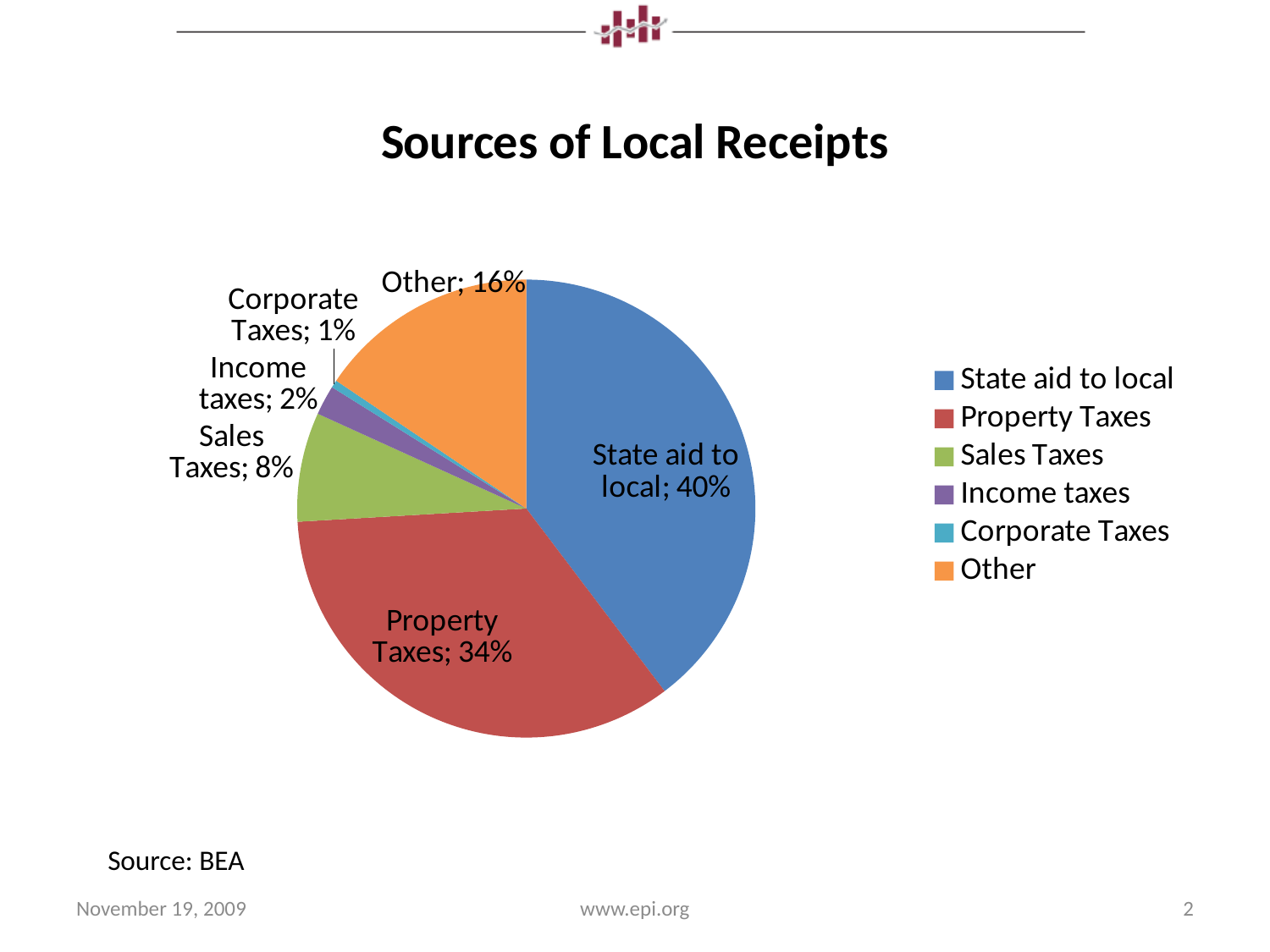
Which source accounts for the largest share of local receipts? State aid to local What share of local receipts comes from Sales Taxes? 8% How many percentage points larger is the State aid to local share than the Property Taxes share? 6 Which is larger, the share for Other or the share for Sales Taxes? Other Which source accounts for the smallest share of local receipts? Corporate Taxes What share of local receipts comes from State aid to local? 40% What share of local receipts comes from Property Taxes? 34% How many categories does the legend list? 6 What kind of chart is shown on the slide? pie chart What is the title of the chart? Sources of Local Receipts What is the source cited for the chart data? BEA